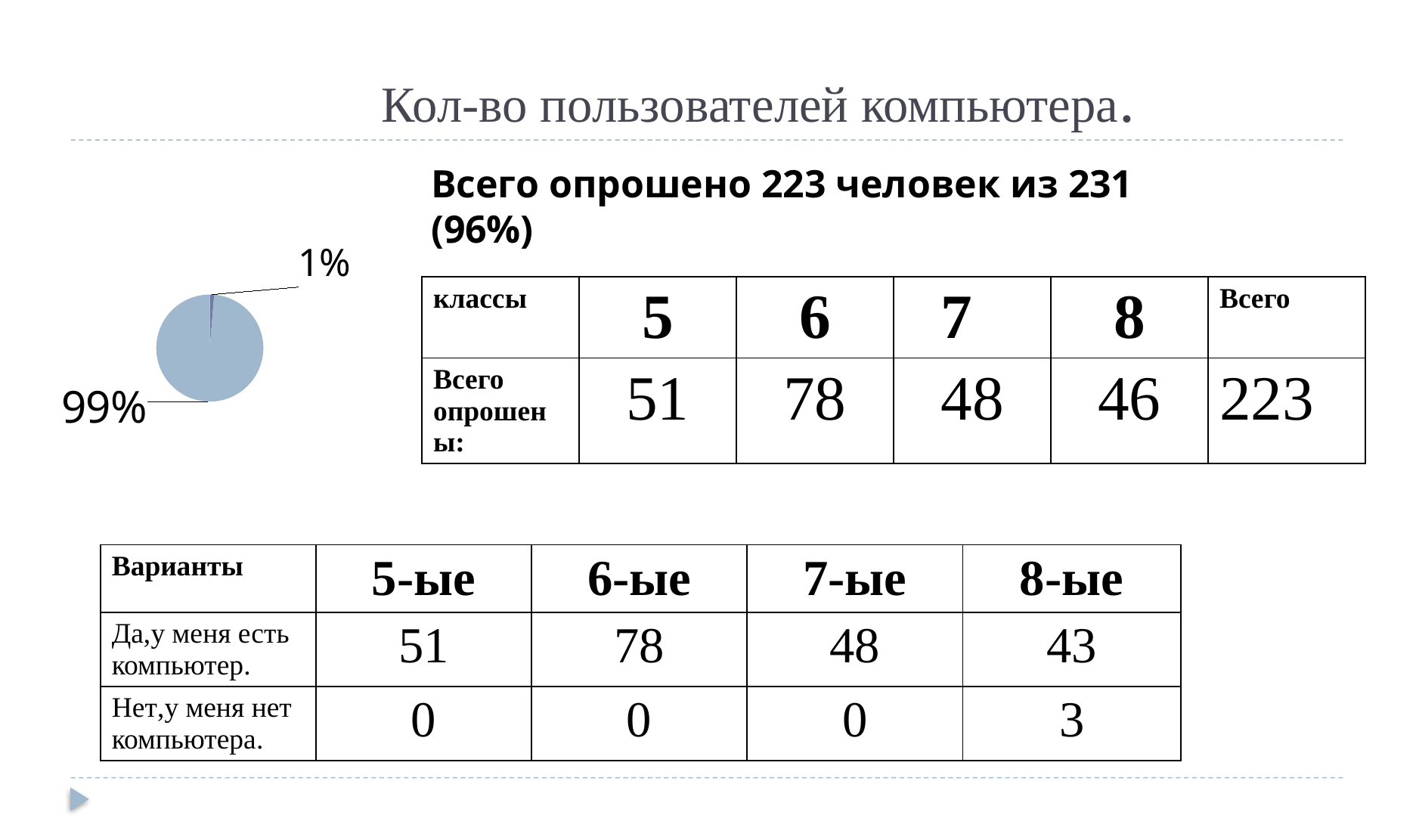
What kind of chart is shown on the left of the slide? pie chart What share of the pie does the smallest slice represent? 1% How many slices does the pie chart have? 2 Which slice is larger in the pie chart, the one labelled 99% or the one labelled 1%? 99% Is the smaller slice of the pie chart greater or less than 10%? less Is the larger slice of the pie chart greater or less than 50%? greater Does the pie chart display a legend? No What is the title of the slide containing the pie chart? Кол-во пользователей компьютера. What share of the pie does the largest slice represent? 99% What is the difference in percentage points between the two slices of the pie chart? 98 percentage points